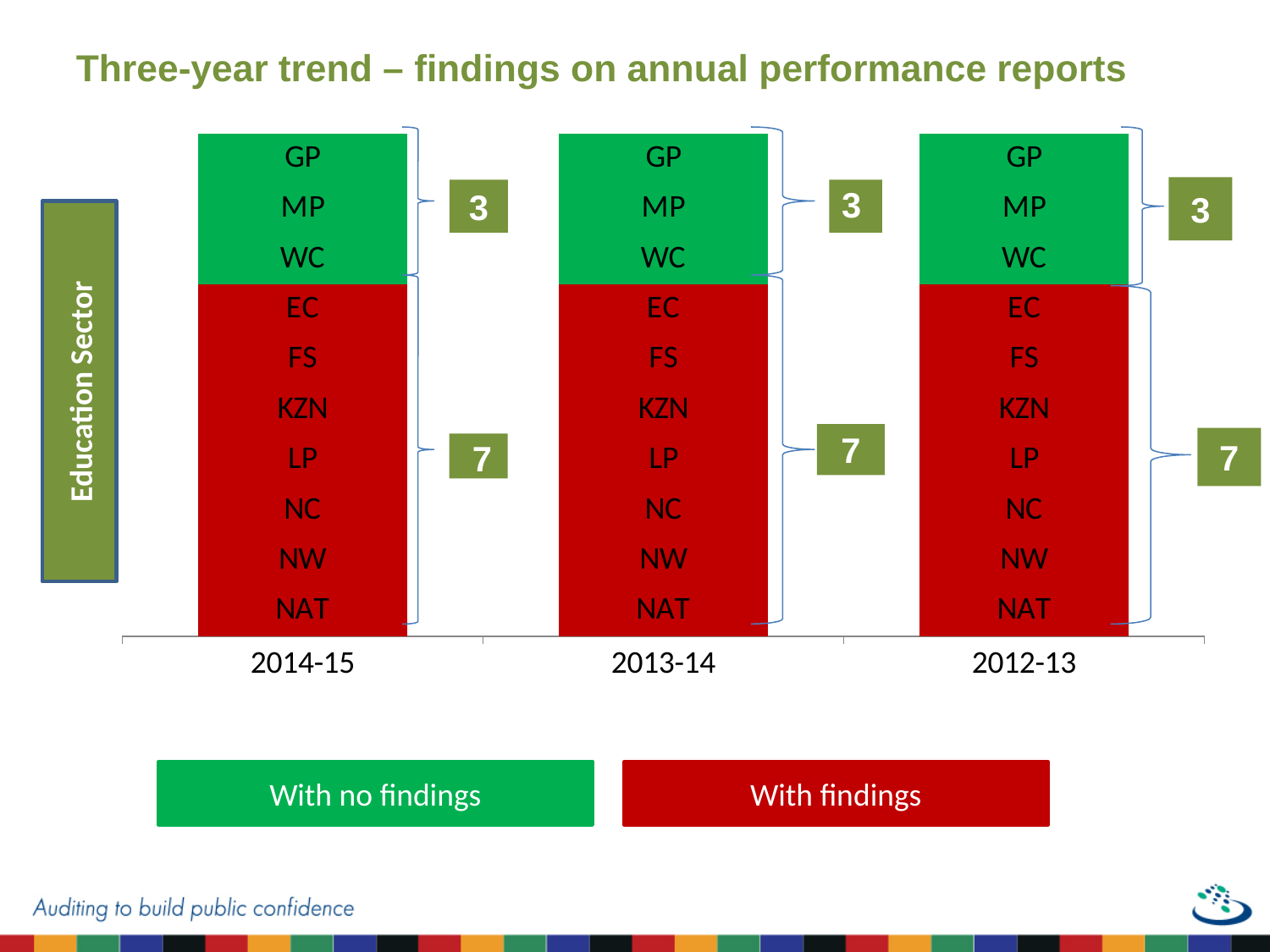
Which colour represents 'With findings' in the legend? Red What is the total of the stacked bar for 2014-15? 10 What kind of chart is shown on the slide? Stacked bar chart Does the number of auditees 'With no findings' rise, fall or stay the same across the three years? Stays the same What is the title of the chart? Three-year trend – findings on annual performance reports How many years (categories) are shown on the x axis? 3 How many series does the legend list? 2 What is the value for 'With findings' in 2012-13? 7 What is the value for 'With findings' in 2013-14? 7 What is the difference between 'With findings' and 'With no findings' in 2012-13? 4 What is the value for 'With no findings' in 2014-15? 3 Which is larger in 2013-14, 'With findings' or 'With no findings'? With findings